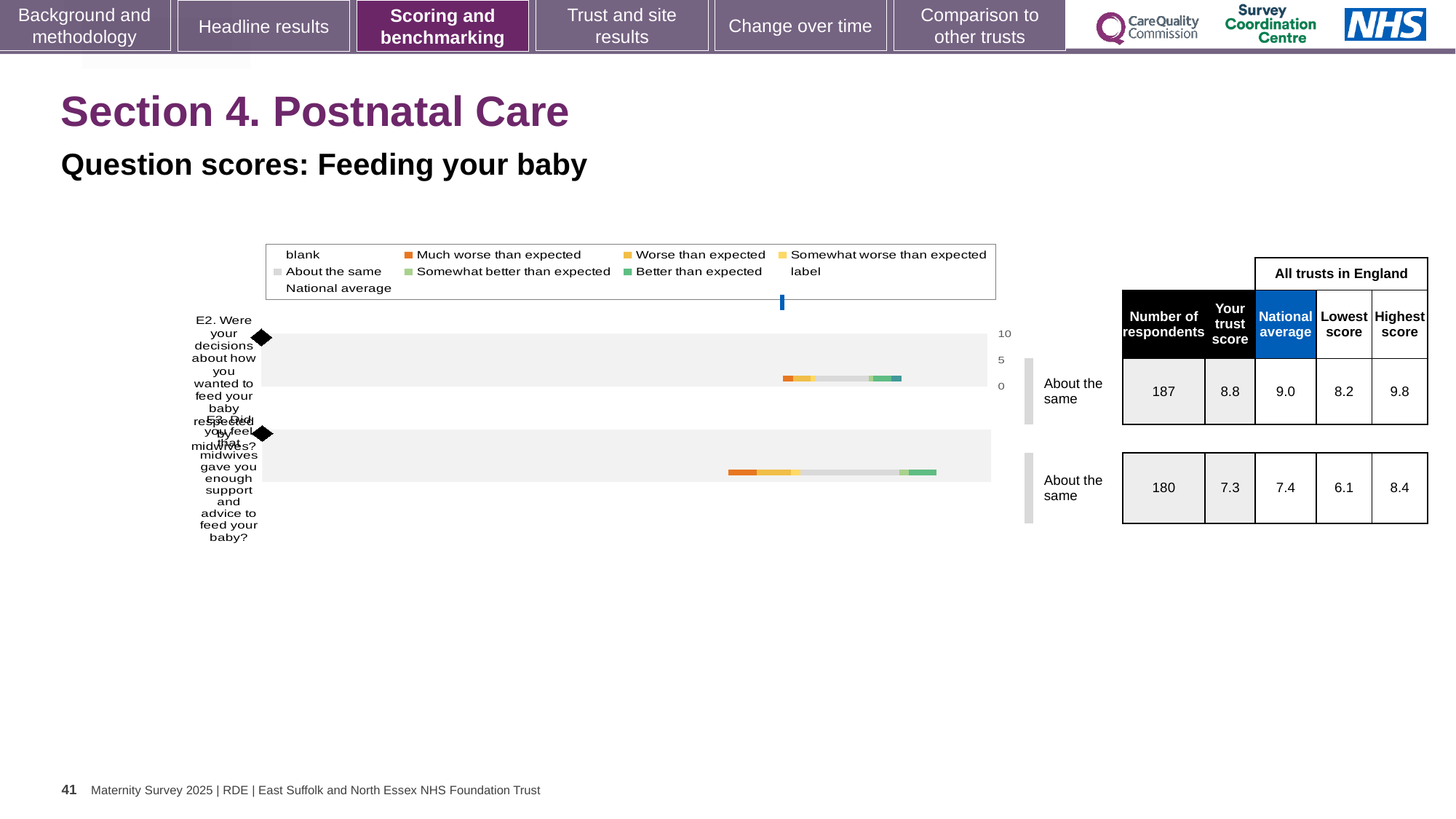
What is the highest score among all trusts in England for question E2? 9.8 What kind of chart is used to show the question scores on this slide? bar chart How many respondents answered question E2? 187 What is the difference between the highest and lowest scores for question E2? 1.6 What colour is used in the legend for 'Much worse than expected'? orange What is the lowest score among all trusts in England for question E3? 6.1 What is the national average for question E3 (midwives gave you enough support and advice to feed your baby)? 7.4 What is the difference between the trust score and the national average for question E3? 0.1 How many questions (categories) are plotted in the chart? 2 Which question has the higher trust score, E2 or E3? E2 How is the trust's result for question E2 categorised relative to expectations? About the same What is the trust score for question E2 (decisions about how you wanted to feed your baby respected by midwives)? 8.8